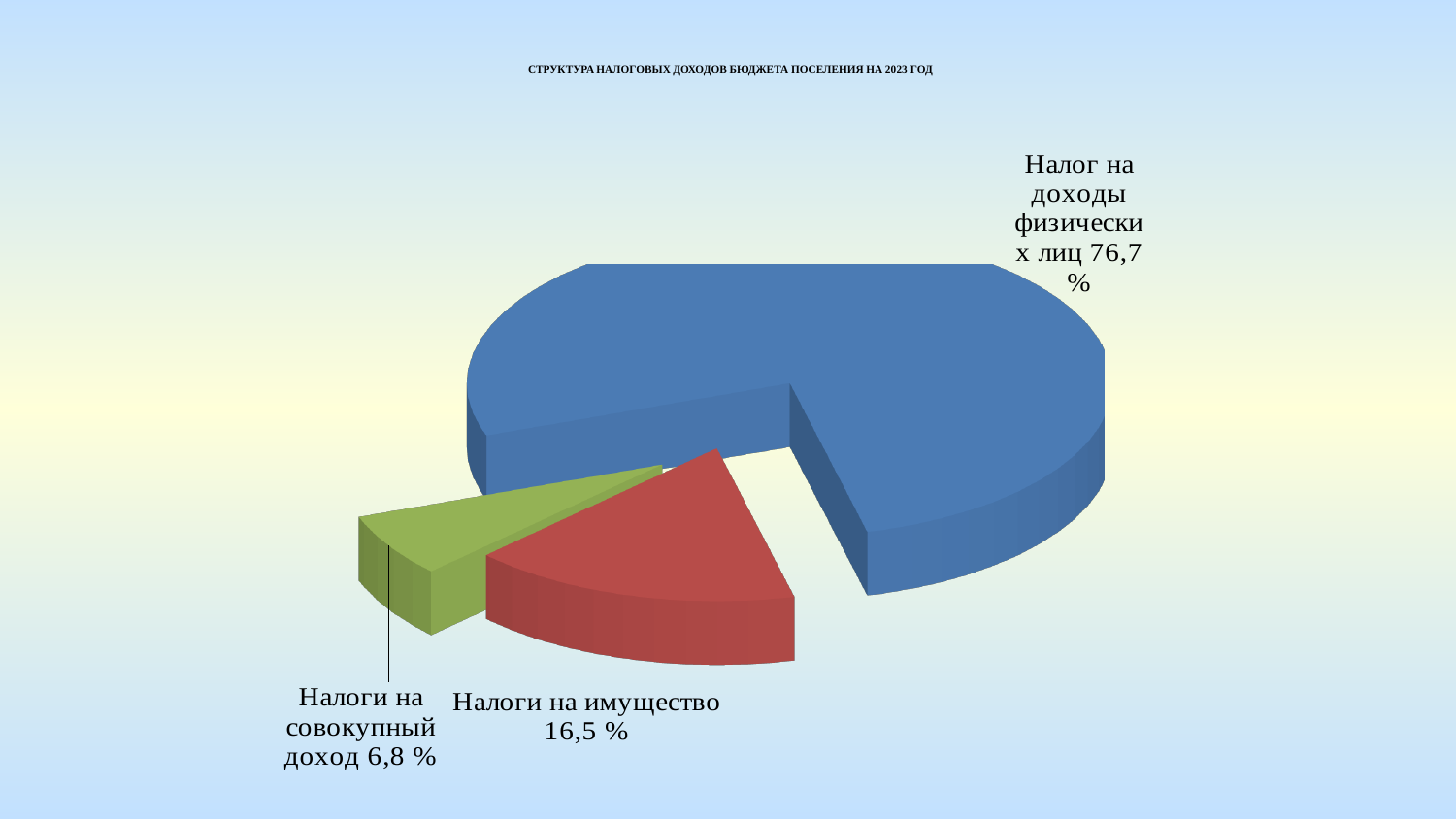
Which category has the smallest slice of the pie? Налоги на совокупный доход What share of tax revenues does "Налоги на имущество" account for? 16,5 % What share of tax revenues does "Налоги на совокупный доход" account for? 6,8 % How many slices does the pie chart have? 3 What colour is the slice for "Налоги на имущество"? Red What is the difference in percentage points between "Налог на доходы физических лиц" and "Налоги на имущество"? 60,2 Which category has the largest slice of the pie? Налог на доходы физических лиц What is the title of the chart on the slide? СТРУКТУРА НАЛОГОВЫХ ДОХОДОВ БЮДЖЕТА ПОСЕЛЕНИЯ НА 2023 ГОД What share of tax revenues does "Налог на доходы физических лиц" account for? 76,7 % What kind of chart is shown on the slide? Pie chart Which is larger: the share of "Налоги на имущество" or the share of "Налоги на совокупный доход"? Налоги на имущество What is the difference in percentage points between "Налоги на имущество" and "Налоги на совокупный доход"? 9,7